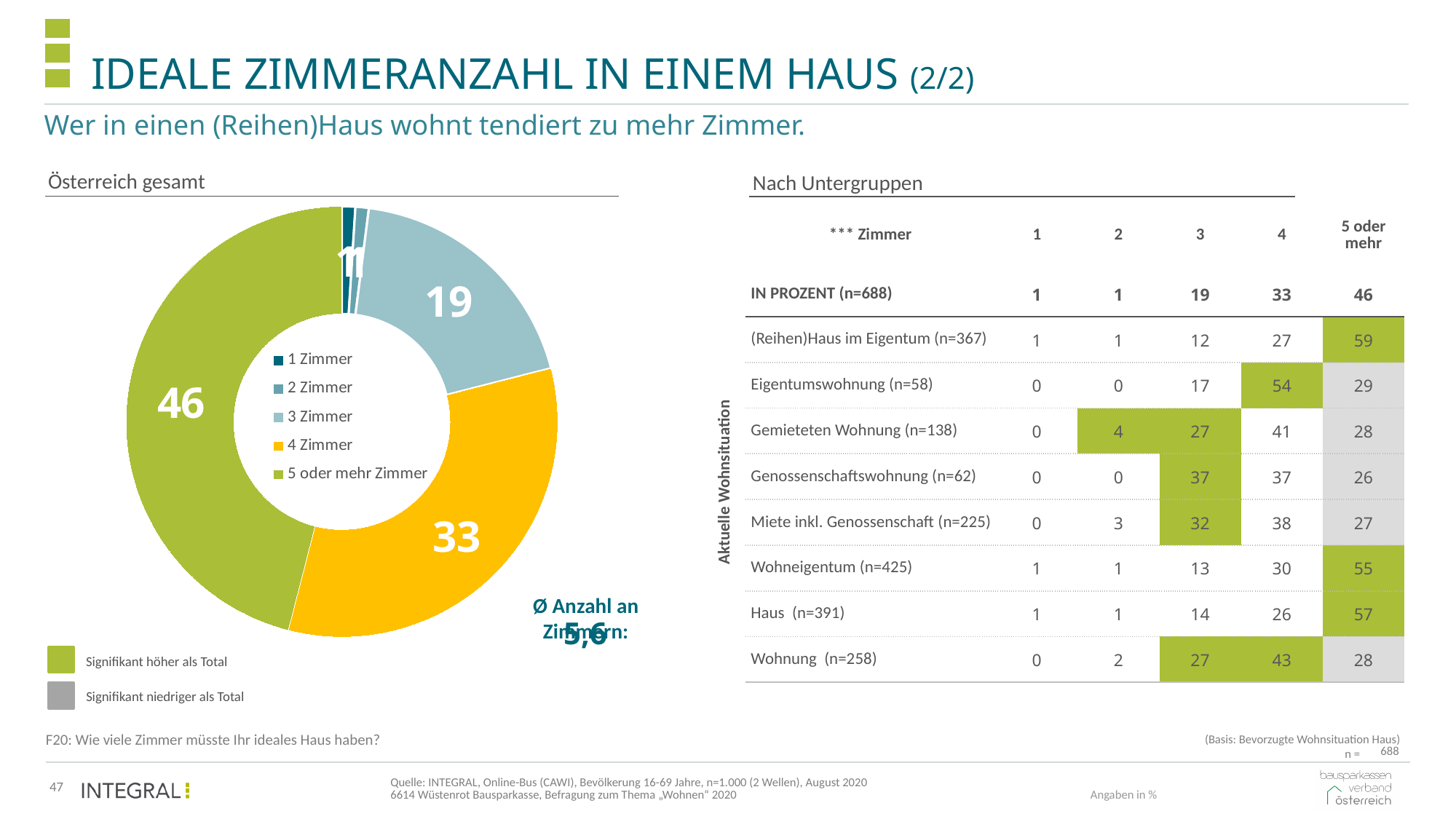
In the "Österreich gesamt" chart, what colour is the slice for "4 Zimmer"? Yellow How many categories does the legend of the "Österreich gesamt" chart list? 5 In the "Österreich gesamt" chart, what is the value for "4 Zimmer"? 33 In the "Österreich gesamt" chart, what is the value for "3 Zimmer"? 19 What kind of chart is shown under "Österreich gesamt"? Pie chart (donut) In the "Österreich gesamt" chart, what is the difference between the values for "5 oder mehr Zimmer" and "4 Zimmer"? 13 In the "Österreich gesamt" chart, what is the value for "1 Zimmer"? 1 In the "Österreich gesamt" chart, which is larger: the slice for "3 Zimmer" or the slice for "4 Zimmer"? 4 Zimmer In the "Österreich gesamt" chart, which category has the largest slice? 5 oder mehr Zimmer In the "Österreich gesamt" chart, what is the value for "5 oder mehr Zimmer"? 46 What average number of rooms (Ø Anzahl an Zimmern) is shown next to the "Österreich gesamt" chart? 5,6 In the "Österreich gesamt" chart, what is the difference between the values for "4 Zimmer" and "3 Zimmer"? 14